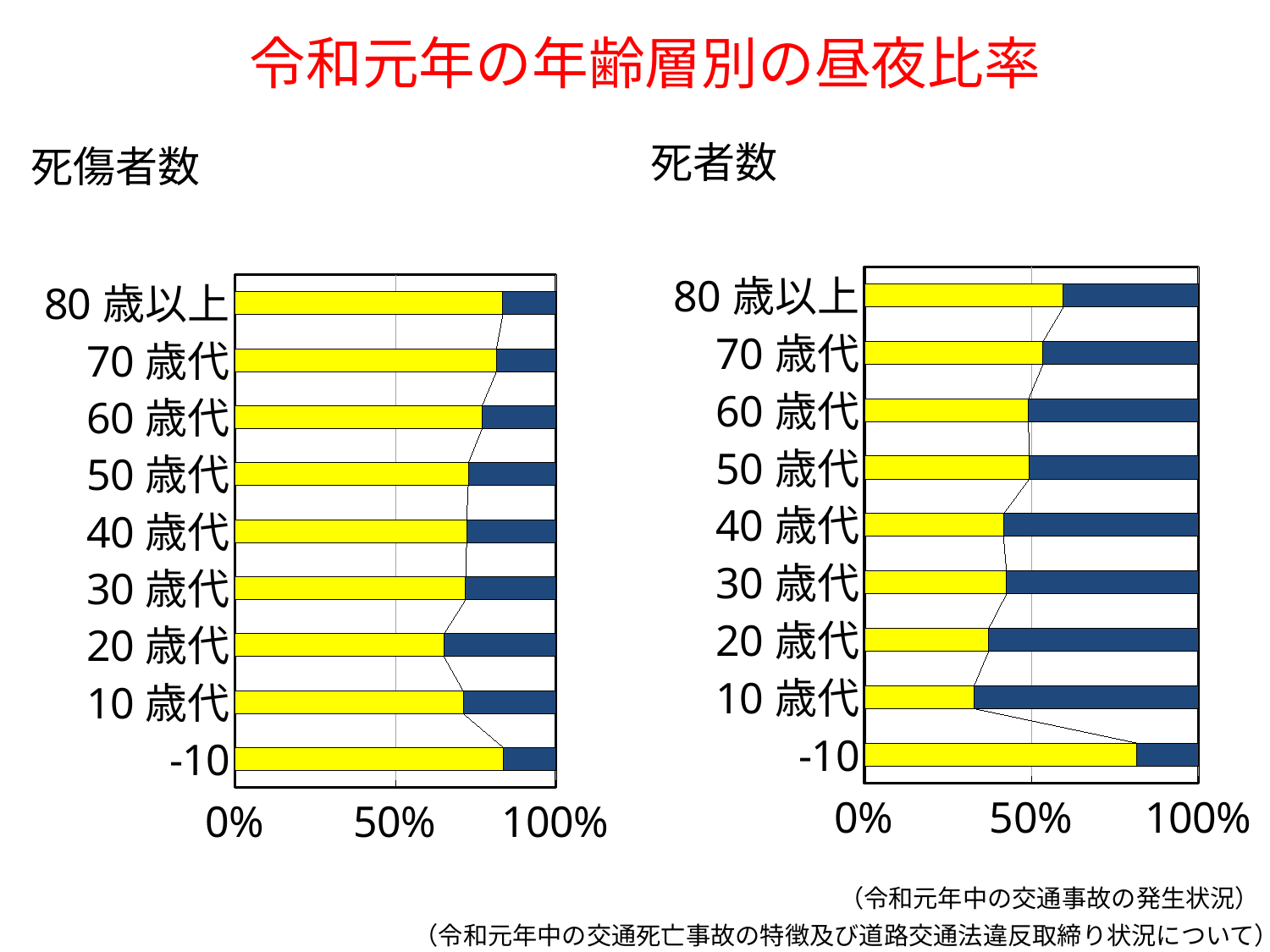
How many age categories are shown on the 死傷者数 chart on the left? 9 On the 死者数 chart on the right, is the yellow share for -10 greater or less than 50%? greater On the 死者数 chart on the right, is the yellow share for 10 歳代 greater or less than 50%? less On the 死者数 chart on the right, is the yellow share for 20 歳代 greater or less than 50%? less On the 死者数 chart on the right, which age category has the largest yellow share? -10 What kind of chart is the 死傷者数 chart on the left? bar chart What is the title of the slide? 令和元年の年齢層別の昼夜比率 On the 死者数 chart on the right, which age category has the smallest yellow share? 10 歳代 How many age categories are shown on the 死者数 chart on the right? 9 On the 死傷者数 chart on the left, which age category has the smallest yellow share? 20 歳代 On the 死者数 chart on the right, which has the larger yellow share, -10 or 10 歳代? -10